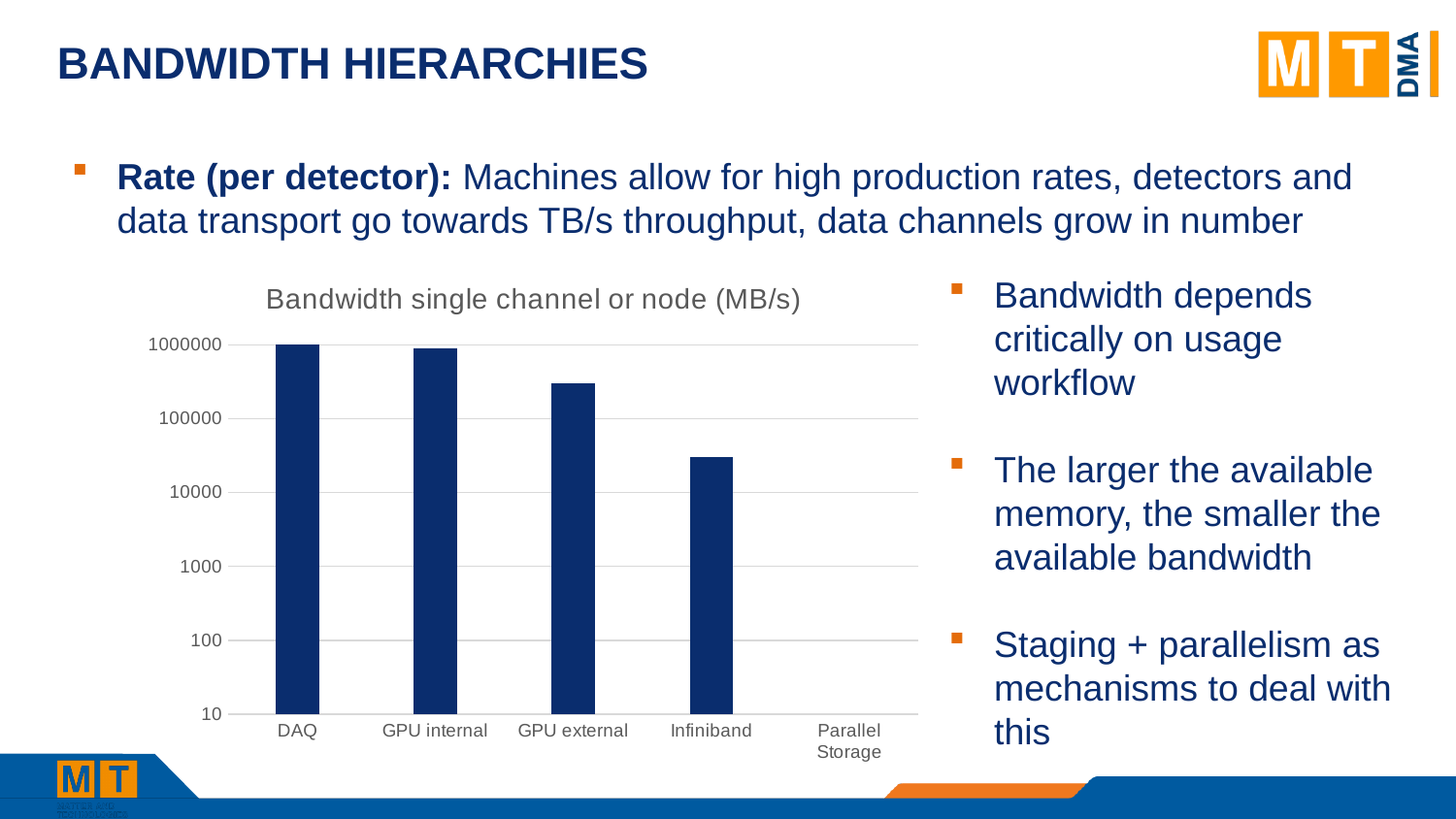
Which is larger, the value for GPU external or the value for Infiniband? GPU external Is the value for Infiniband greater or less than 100000? less How many categories are shown on the x axis of the chart? 5 Which is larger, the value for DAQ or the value for Infiniband? DAQ What is the value for DAQ in the chart? 1000000 Is the value for GPU external greater or less than 100000? greater What kind of chart is shown on the slide? bar chart What is the title of the chart? Bandwidth single channel or node (MB/s) Is the value for GPU external greater or less than 1000000? less What is the highest tick value shown on the y axis of the chart? 1000000 Do the bar values rise or fall moving from left to right along the x axis? fall